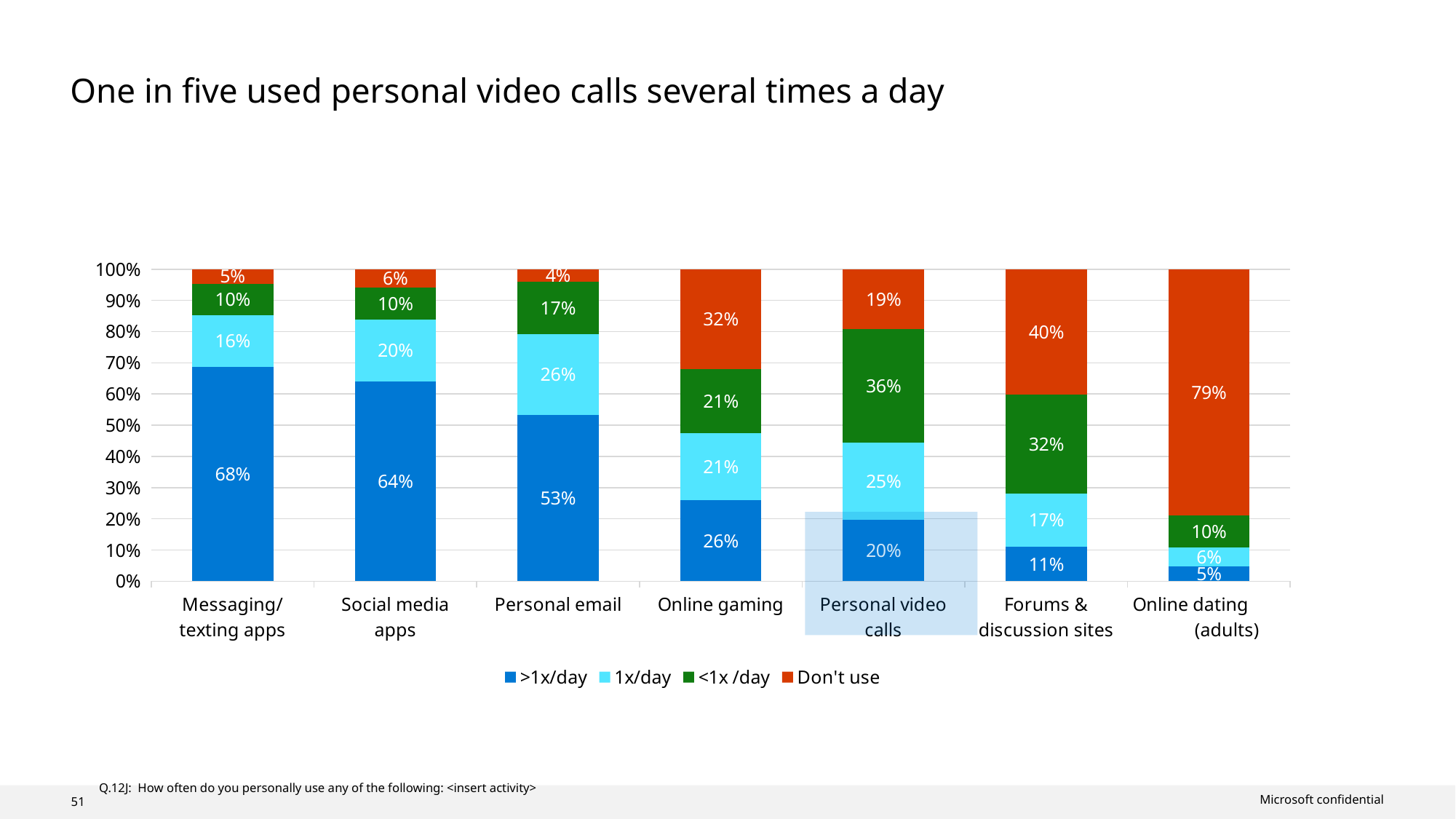
What is the '<1x /day' value for Forums & discussion sites? 32% How many activities are shown on the x axis? 7 Which series is shown in red in the legend? Don't use How many series does the legend list? 4 Which is larger: the 'Don't use' value for Online gaming or for Forums & discussion sites? Forums & discussion sites What is the total of the stacked bar for Personal video calls? 100% What is the difference between the '>1x/day' values for Messaging/ texting apps and Social media apps? 4% What percentage of respondents use personal video calls more than once a day (>1x/day)? 20% What kind of chart is shown on the slide? Stacked bar chart Which activity has the highest '>1x/day' value? Messaging/ texting apps Which activity has the lowest 'Don't use' value? Personal email What is the 'Don't use' value for Online dating (adults)? 79%